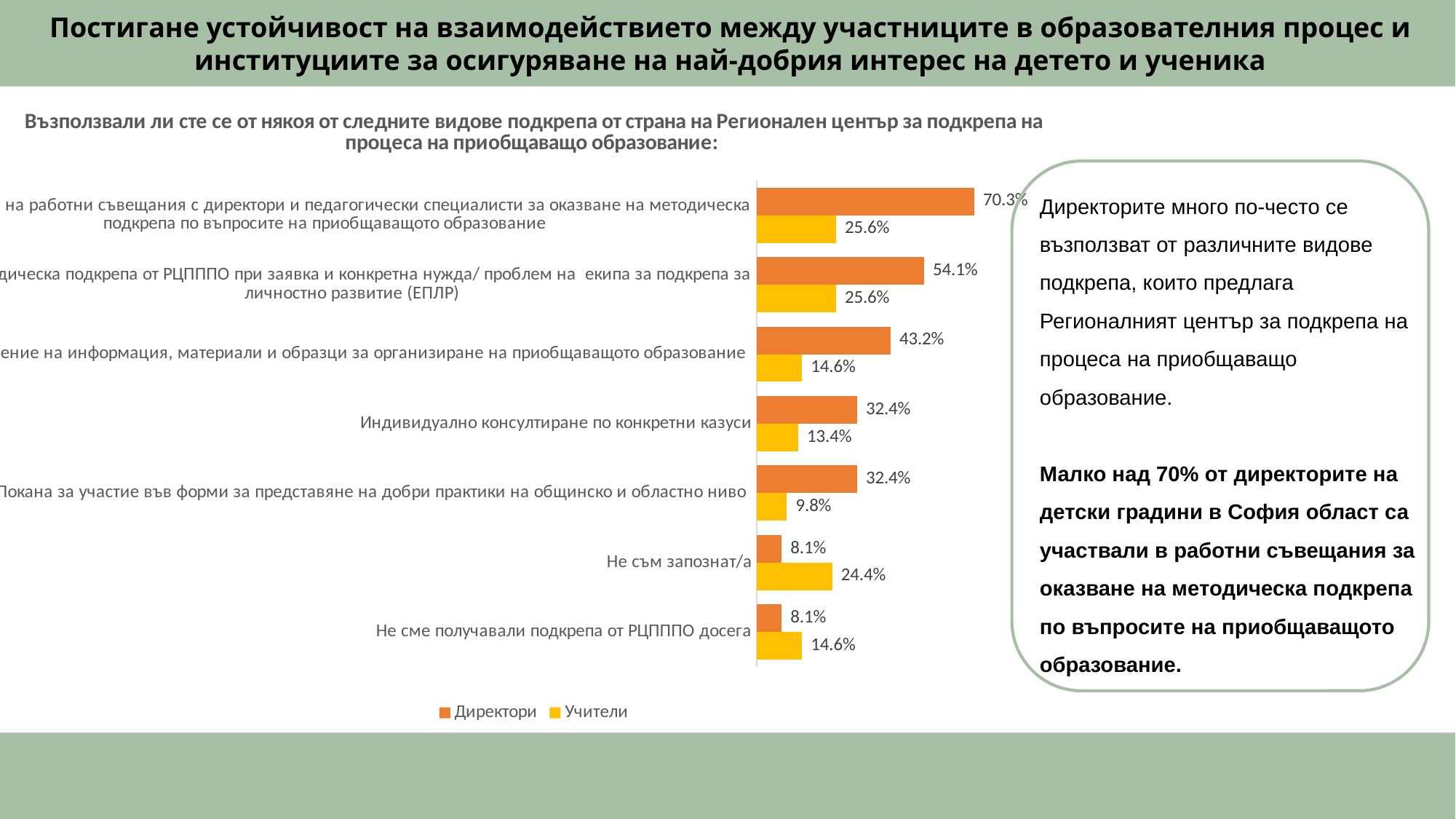
What are the two series named in the chart legend? Директори and Учители What is the Учители value for 'Покана за участие във форми за представяне на добри практики на общинско и областно ниво'? 9.8% What is the difference between the Директори and Учители values for 'Индивидуално консултиране по конкретни казуси'? 19.0 percentage points What is the Директори value for 'Не сме получавали подкрепа от РЦПППО досега'? 8.1% For 'Не съм запознат/а', which series has the larger value, Директори or Учители? Учители How many series does the chart legend list? 2 Which category has the lowest Учители value? Покана за участие във форми за представяне на добри практики на общинско и областно ниво What is the Учители value for 'Не съм запознат/а'? 24.4% What is the Директори value for 'Индивидуално консултиране по конкретни казуси'? 32.4% What kind of chart is shown on the slide? Bar chart How many categories are plotted in the chart? 7 What is the difference between the Учители and Директори values for 'Не сме получавали подкрепа от РЦПППО досега'? 6.5 percentage points